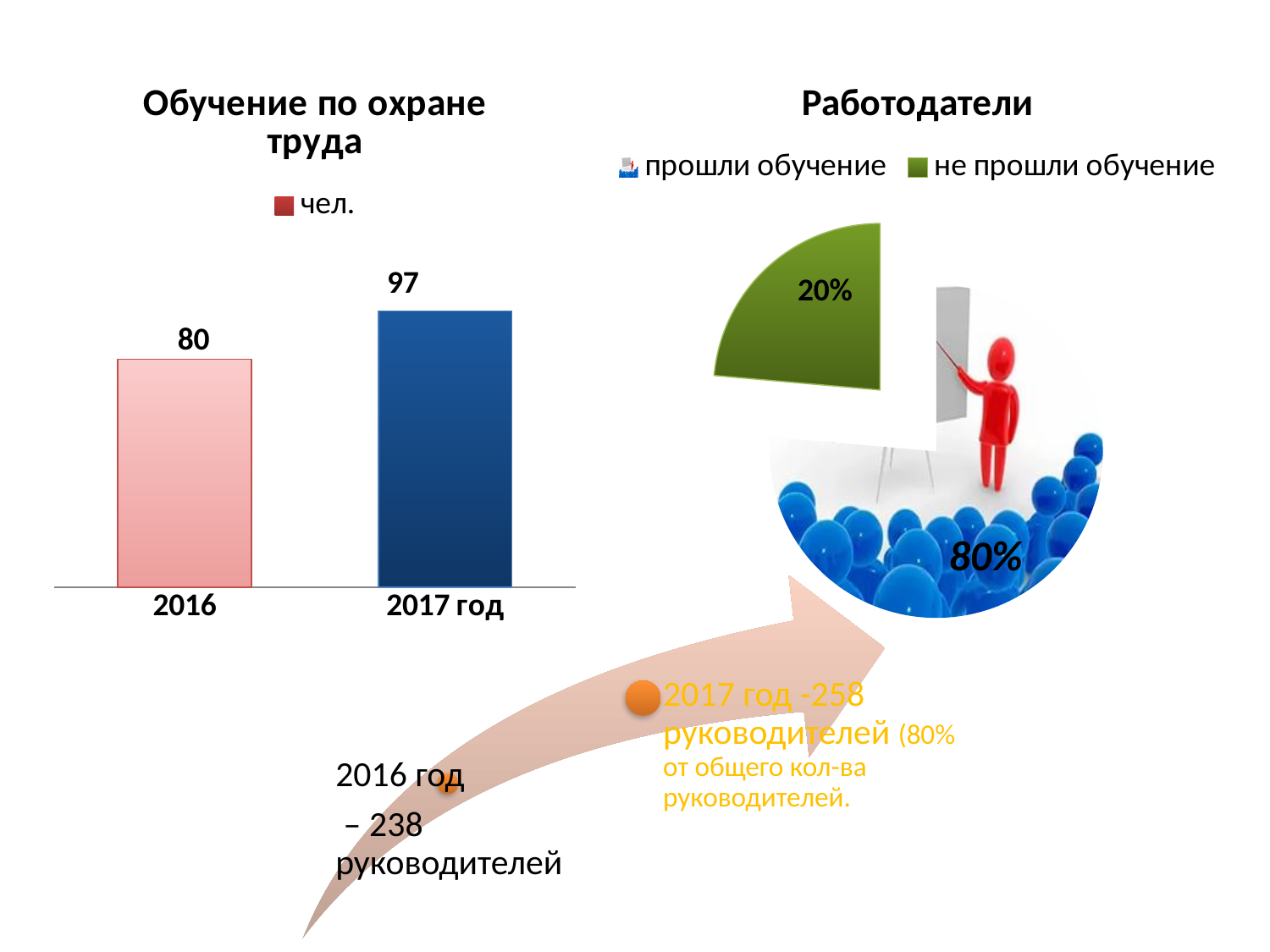
How many entries does the legend of the chart titled "Работодатели" list? 2 In the chart titled "Обучение по охране труда", what is the value for 2016? 80 In the chart titled "Работодатели", what share of the pie is "прошли обучение"? 80% What series name does the legend of the chart titled "Обучение по охране труда" show? чел. In the chart titled "Обучение по охране труда", which category has the lowest value? 2016 How many categories are shown in the chart titled "Обучение по охране труда"? 2 In the chart titled "Обучение по охране труда", what is the value for 2017 год? 97 In the chart titled "Обучение по охране труда", which category has the highest value? 2017 год In the chart titled "Обучение по охране труда", do the values rise or fall from 2016 to 2017 год? rise In the chart titled "Работодатели", what share of the pie is "не прошли обучение"? 20% What kind of chart is the one titled "Обучение по охране труда"? bar chart In the chart titled "Обучение по охране труда", what is the difference between the values for 2017 год and 2016? 17